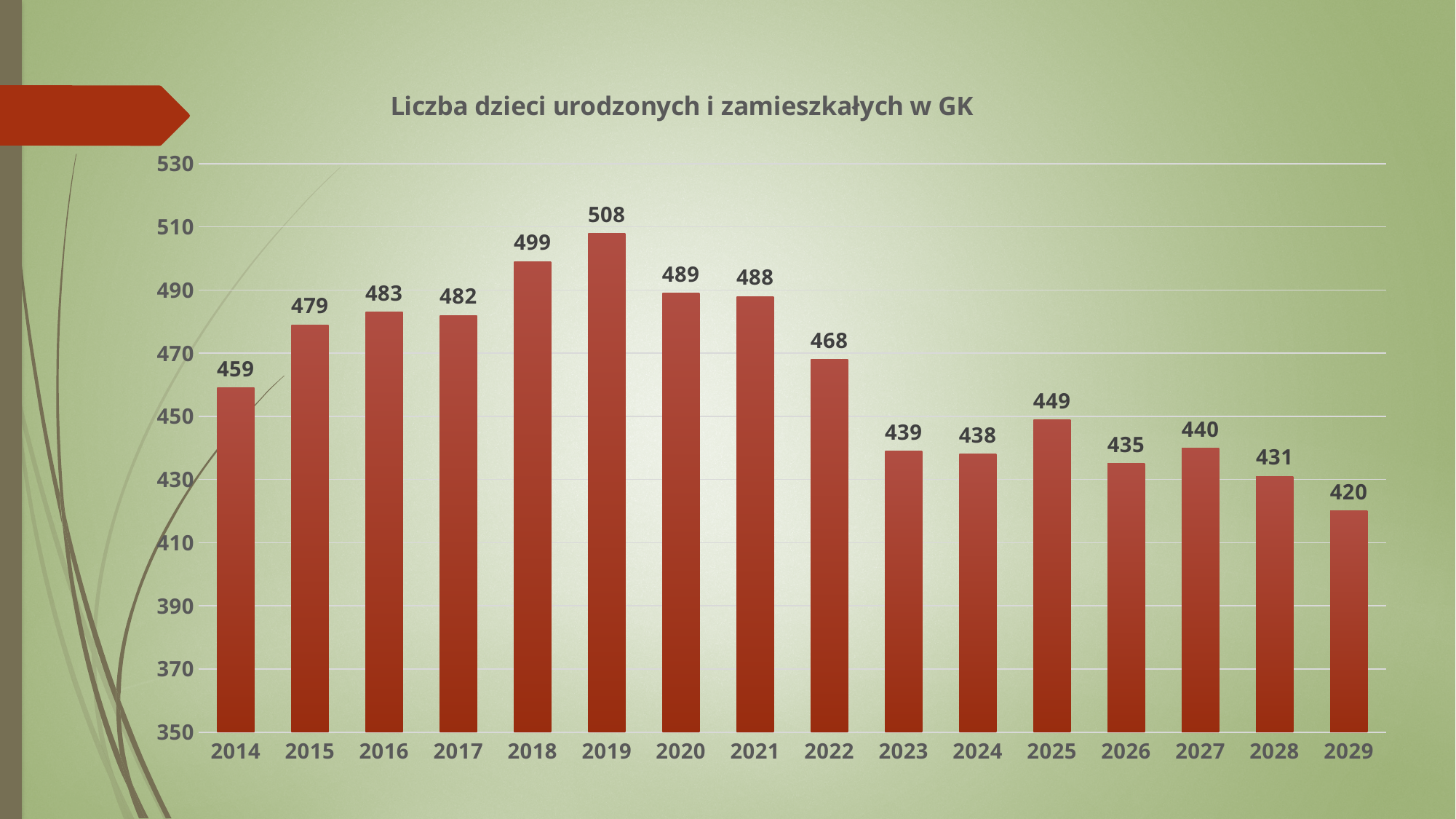
How many years are shown on the x axis? 16 Which year has the highest value? 2019 Which is larger, the value for 2018 or the value for 2020? 2018 What is the title of the chart? Liczba dzieci urodzonych i zamieszkałych w GK Is the value for 2025 greater or less than 450? less What is the value for 2019? 508 Which year has the lowest value? 2029 What is the difference between the values for 2014 and 2015? 20 What is the value for 2022? 468 What is the value for 2029? 420 What is the difference between the values for 2019 and 2029? 88 What kind of chart is this? bar chart